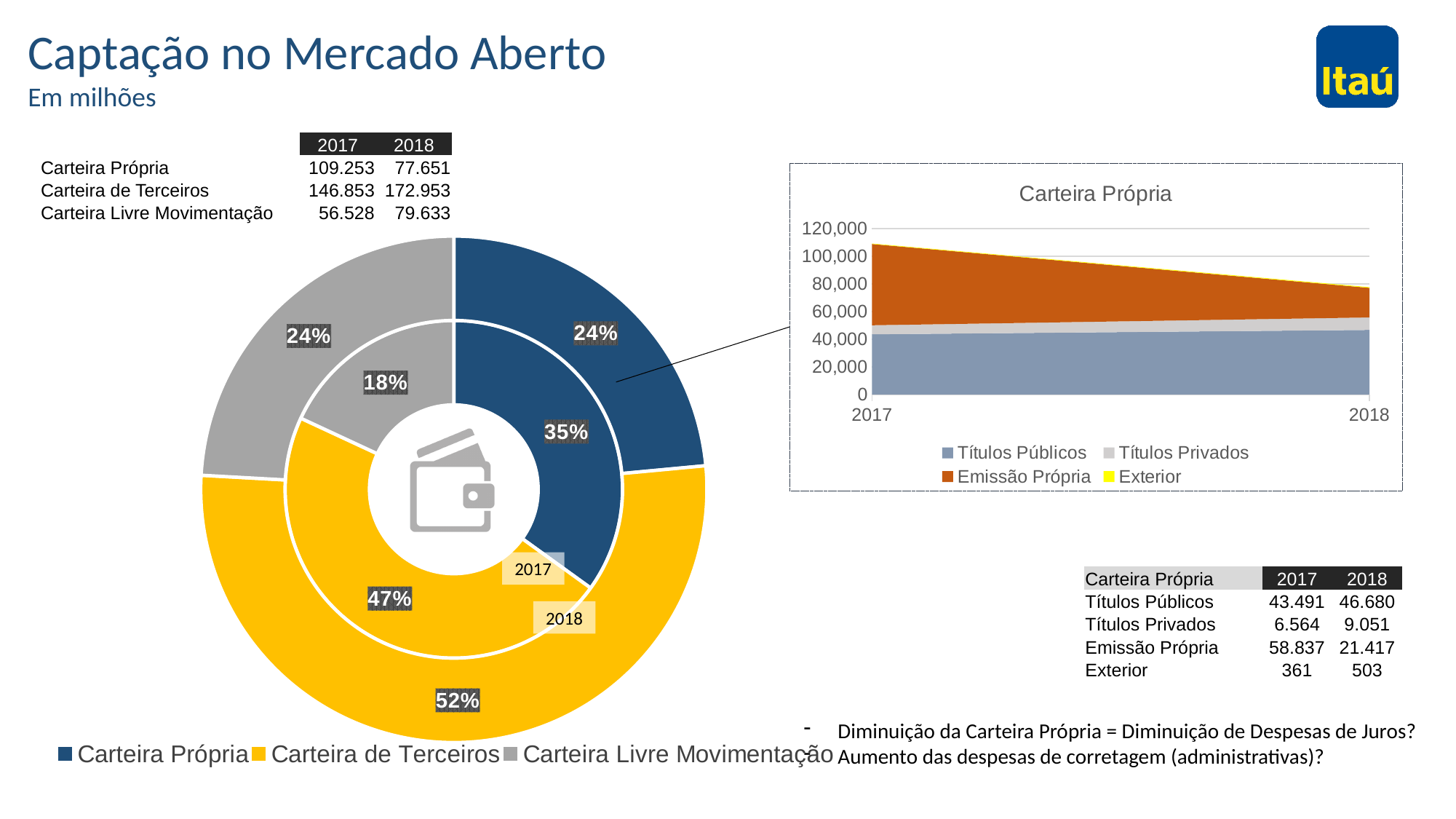
In the doughnut chart, what share does Carteira Livre Movimentação have in the 2017 (inner) ring? 18% In the 'Carteira Própria' chart, how many series does the legend list? 4 In the 'Carteira Própria' chart, does the total stacked value rise or fall from 2017 to 2018? Fall In the doughnut chart, how many categories does the legend list? 3 In the doughnut chart, which category has the largest share in the 2018 (outer) ring? Carteira de Terceiros In the doughnut chart, by how many percentage points did the share of Carteira Própria change from 2017 (35%) to 2018 (24%)? 11 percentage points In the doughnut chart, which category has the smallest share in the 2017 (inner) ring? Carteira Livre Movimentação In the doughnut chart, what share does Carteira Própria have in the 2017 (inner) ring? 35% In the doughnut chart, which colour represents Carteira de Terceiros? Yellow What type of chart is the 'Carteira Própria' chart on the right? Stacked area chart In the doughnut chart, what share does Carteira de Terceiros have in the 2018 (outer) ring? 52% In the 'Carteira Própria' chart, is the total stacked value in 2017 greater or less than 100,000? greater